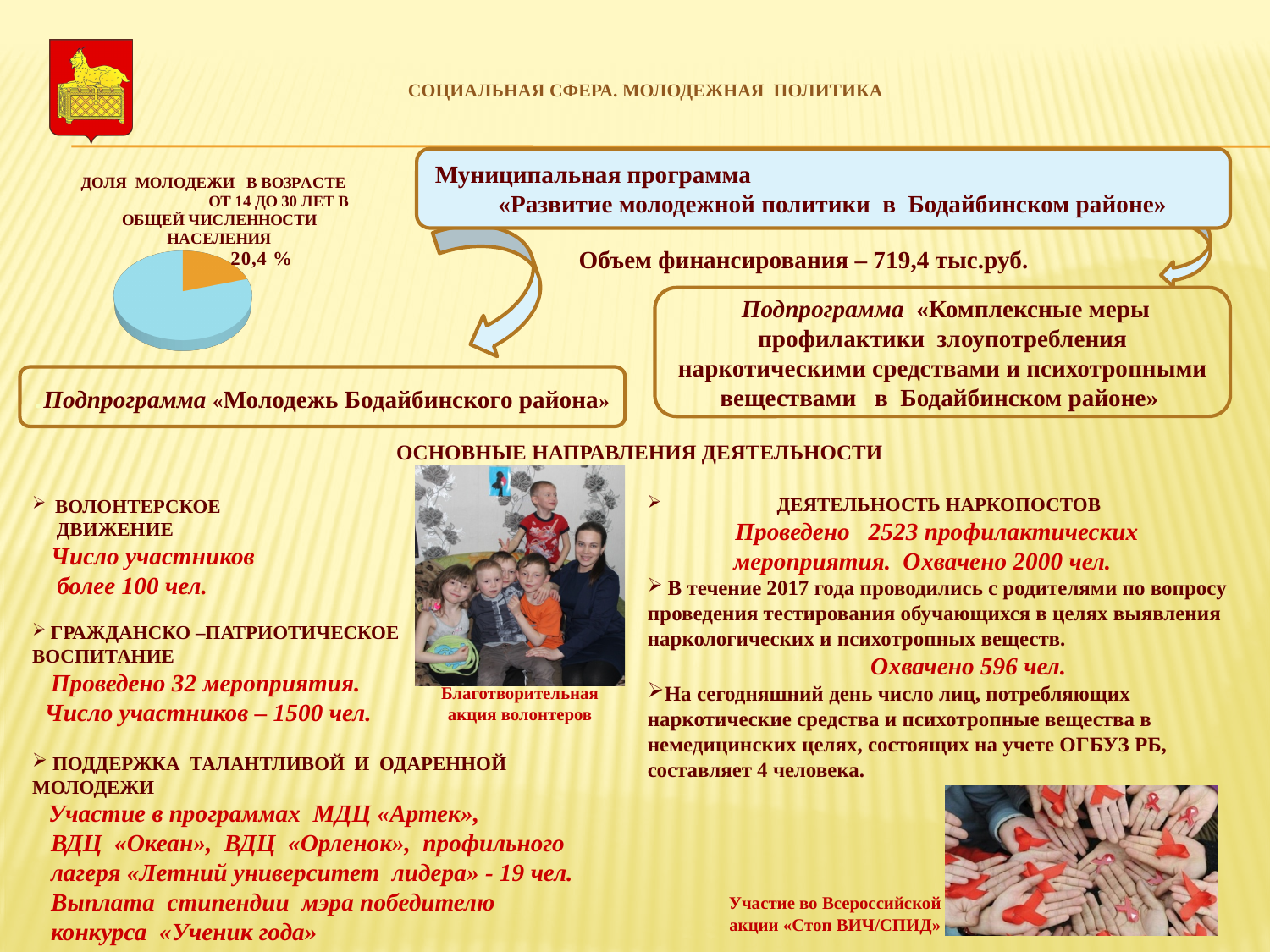
Which slice of the pie chart is the smallest? the orange slice (20,4 %) Which slice of the pie chart is larger: the orange slice or the light blue slice? the light blue slice What is the title of the pie chart? Доля молодежи в возрасте от 14 до 30 лет в общей численности населения What colour is the slice labelled 20,4 % in the pie chart? orange What share of the total population do young people aged 14 to 30 make up, according to the pie chart? 20,4 % What kind of chart is shown on the slide? pie chart How many slices does the pie chart have? 2